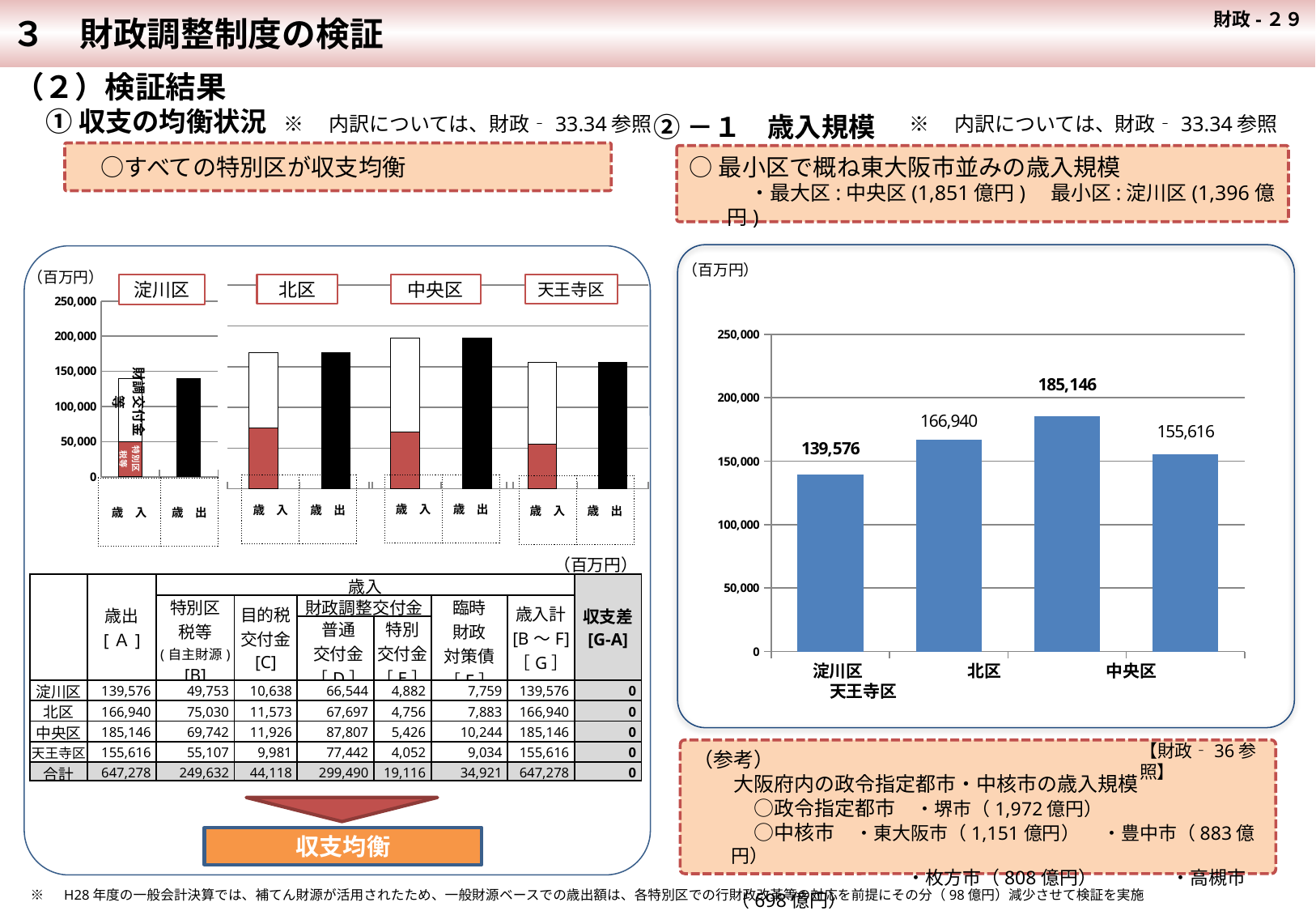
On the right-hand chart (歳入規模), what is the value for 中央区? 185,146 On the right-hand chart (歳入規模), what is the difference between the values for 中央区 and 淀川区? 45,570 On the right-hand chart (歳入規模), what is the value for 淀川区? 139,576 On the right-hand chart (歳入規模), which ward has the lowest value? 淀川区 On the left-hand chart (収支の均衡状況), is the 歳入 bar for 淀川区 greater or less than 150,000? less On the right-hand chart (歳入規模), how many bars are plotted? 4 On the right-hand chart (歳入規模), what is the value for 北区? 166,940 What kind of chart is the right-hand chart (歳入規模)? Bar chart On the right-hand chart (歳入規模), which is larger, the value for 北区 or the value for 天王寺区? 北区 On the left-hand chart (収支の均衡状況), what unit is shown at the top of the vertical axis? 百万円 On the right-hand chart (歳入規模), which ward has the highest value? 中央区 On the left-hand chart (収支の均衡状況), is the 歳出 bar for 中央区 greater or less than 150,000? greater